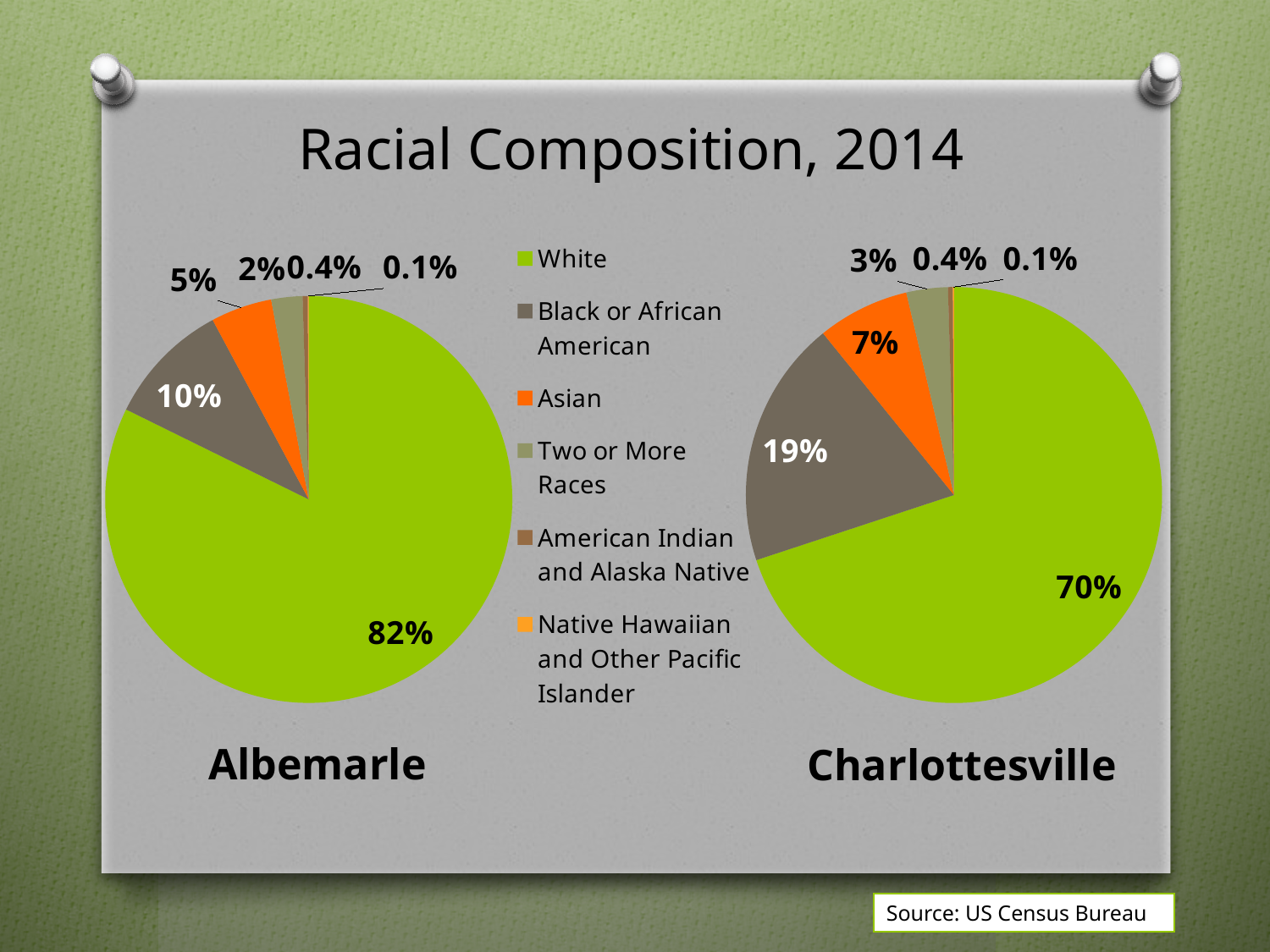
In the Charlottesville pie chart, what share is Black or African American? 19% What colour represents Asian in the pie charts? Orange How many categories does the legend list? 6 What kind of charts are shown on the slide? Pie charts What is the difference between the White share in Albemarle and the White share in Charlottesville? 12% In the Albemarle pie chart, what share is White? 82% What is the title of the slide's charts? Racial Composition, 2014 In the Albemarle pie chart, which category has the largest slice? White Which has a larger Black or African American share, Albemarle or Charlottesville? Charlottesville In the Albemarle pie chart, what share is Asian? 5% In the Charlottesville pie chart, what share is Two or More Races? 3% In the Charlottesville pie chart, which category has the smallest slice? Native Hawaiian and Other Pacific Islander